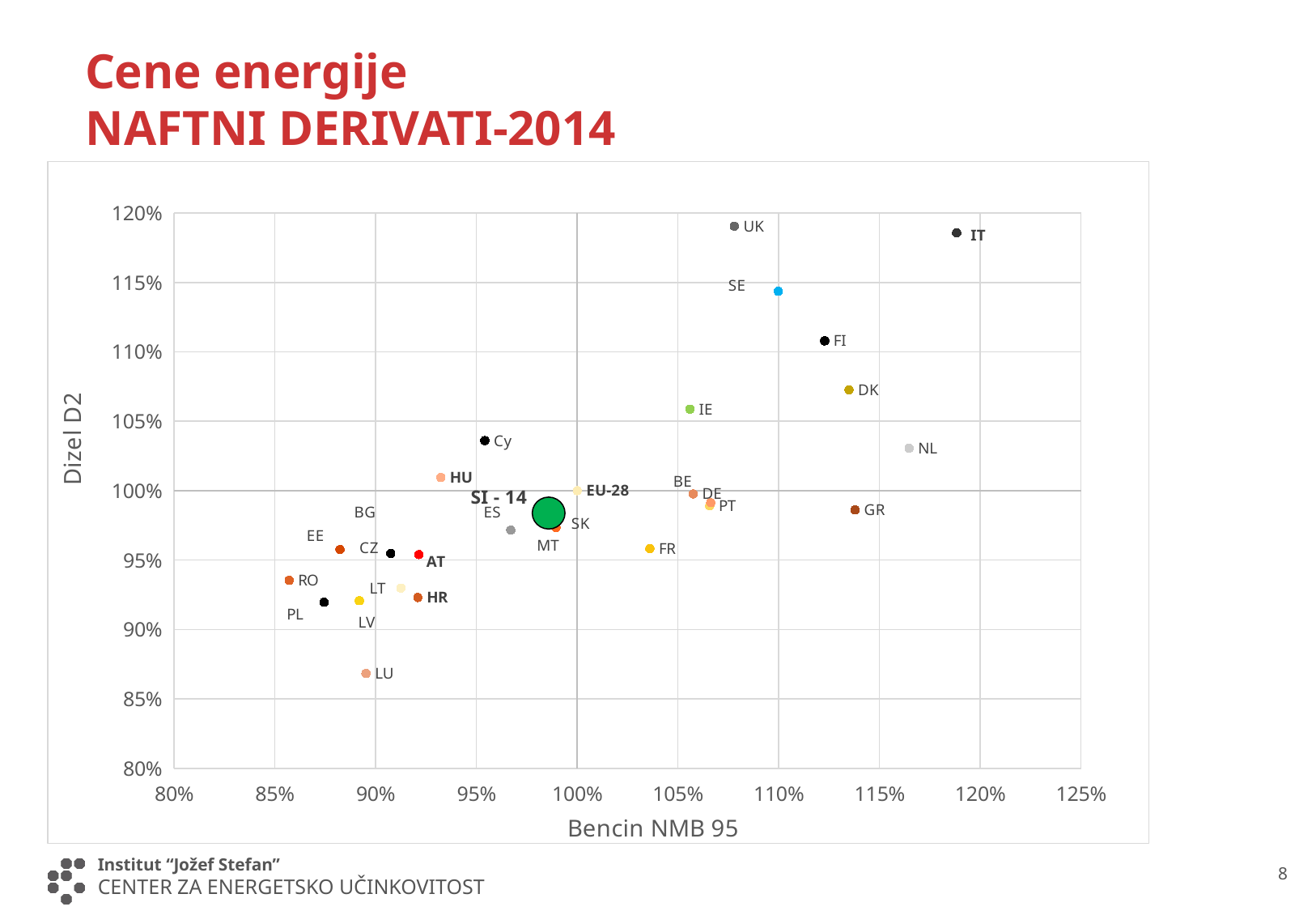
Which point is drawn as a large green circle in the chart? SI - 14 Which country has the highest Bencin NMB 95 value in the chart? IT Is the Bencin NMB 95 value for RO greater or less than 90%? less Is the Bencin NMB 95 value for IT greater or less than 115%? greater Is the Dizel D2 value for LU greater or less than 90%? less Which country has the lowest Dizel D2 value in the chart? LU What is the label of the horizontal axis of the chart? Bencin NMB 95 Which has the higher Bencin NMB 95 value, GR or NL? NL Which country has the lowest Bencin NMB 95 value in the chart? RO What kind of chart is shown on the slide? scatter chart Which has the higher Dizel D2 value, IE or FR? IE